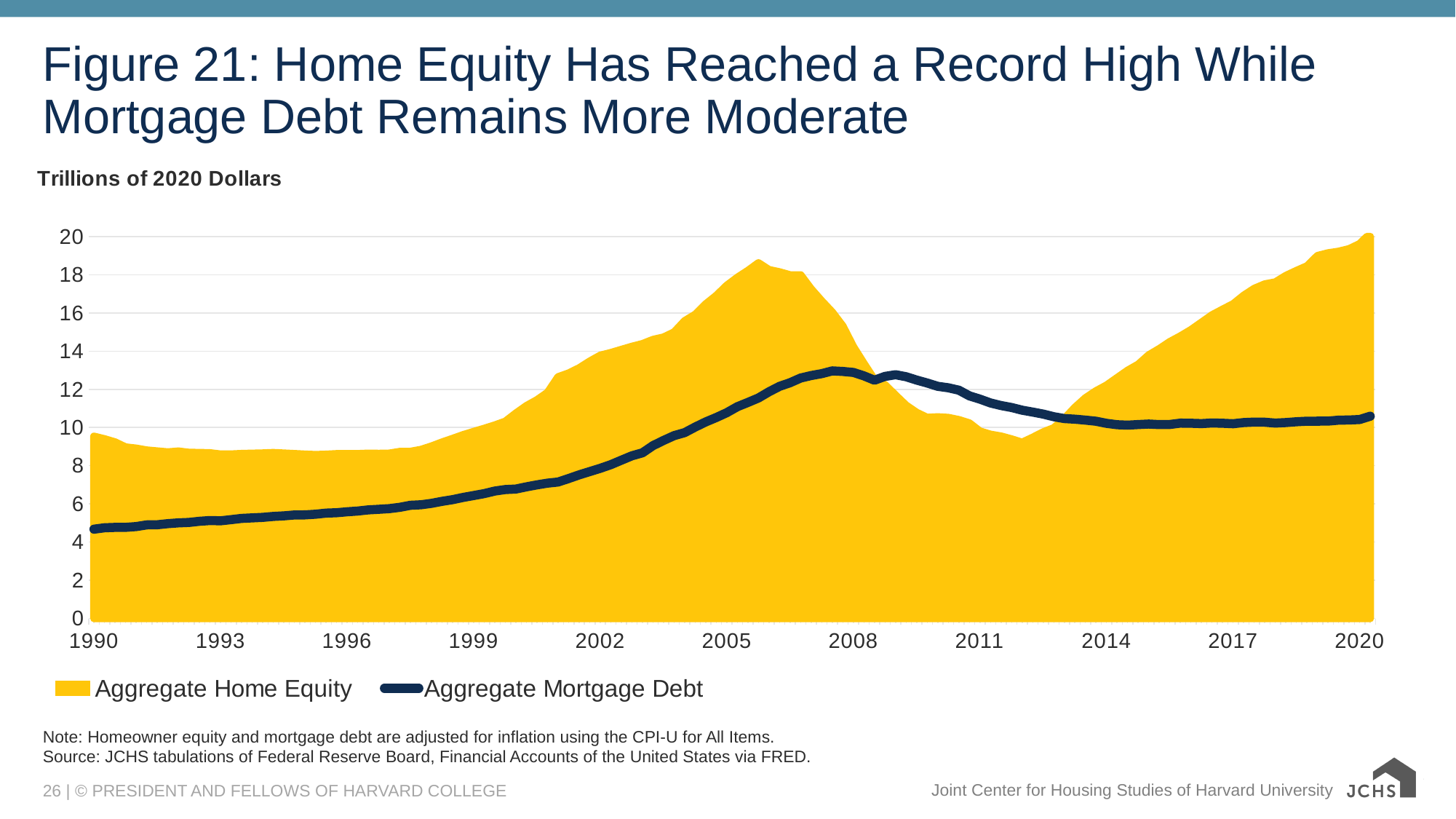
Is the value for Aggregate Mortgage Debt in 2014 greater or less than 12? less How many series does the legend list? 2 What are the two series named in the legend? Aggregate Home Equity and Aggregate Mortgage Debt In 2002, which is larger, Aggregate Home Equity or Aggregate Mortgage Debt? Aggregate Home Equity Is the value for Aggregate Home Equity in 1990 greater or less than 8? greater What unit is stated above the chart for the values? Trillions of 2020 Dollars In which year shown does Aggregate Home Equity reach its highest value? 2020 In 2020, which is larger, Aggregate Home Equity or Aggregate Mortgage Debt? Aggregate Home Equity Does Aggregate Home Equity rise or fall between 2006 and 2011? fall Does Aggregate Mortgage Debt rise or fall between 1990 and 2008? rise Is the value for Aggregate Mortgage Debt in 1990 greater or less than 6? less